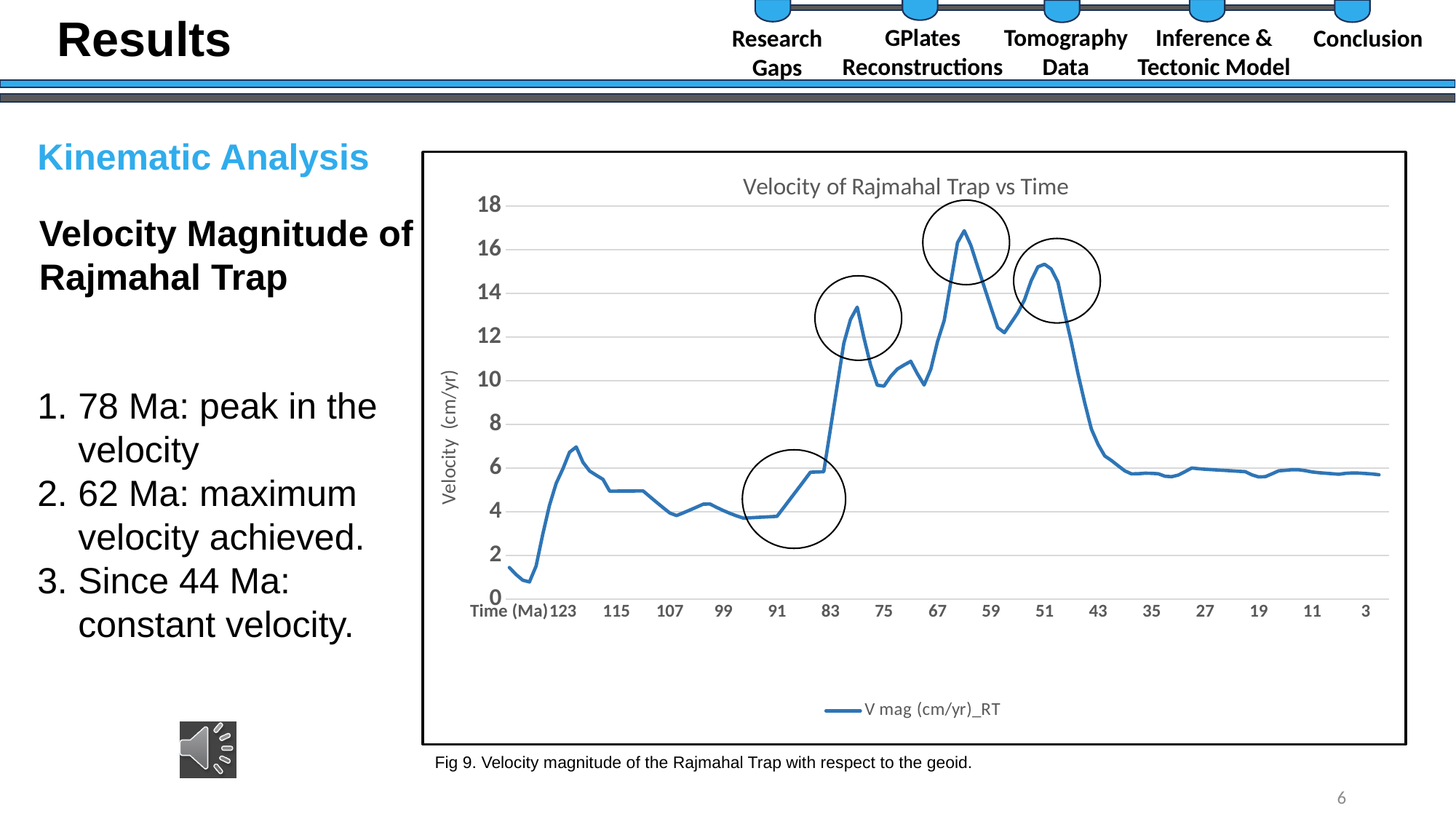
Is the velocity at 107 Ma greater or less than 6 cm/yr? less Is the velocity at 51 Ma greater or less than 14 cm/yr? greater Is the velocity at 35 Ma greater or less than 8 cm/yr? less At what time does the velocity reach its maximum? 62 Ma Which is larger, the velocity at 51 Ma or the velocity at 27 Ma? 51 Ma What kind of chart is shown on the slide? line chart What is the title of the chart? Velocity of Rajmahal Trap vs Time How many series does the chart legend list? 1 What is the name of the series shown in the chart legend? V mag (cm/yr)_RT Between 51 Ma and 43 Ma, does the velocity rise or fall? fall